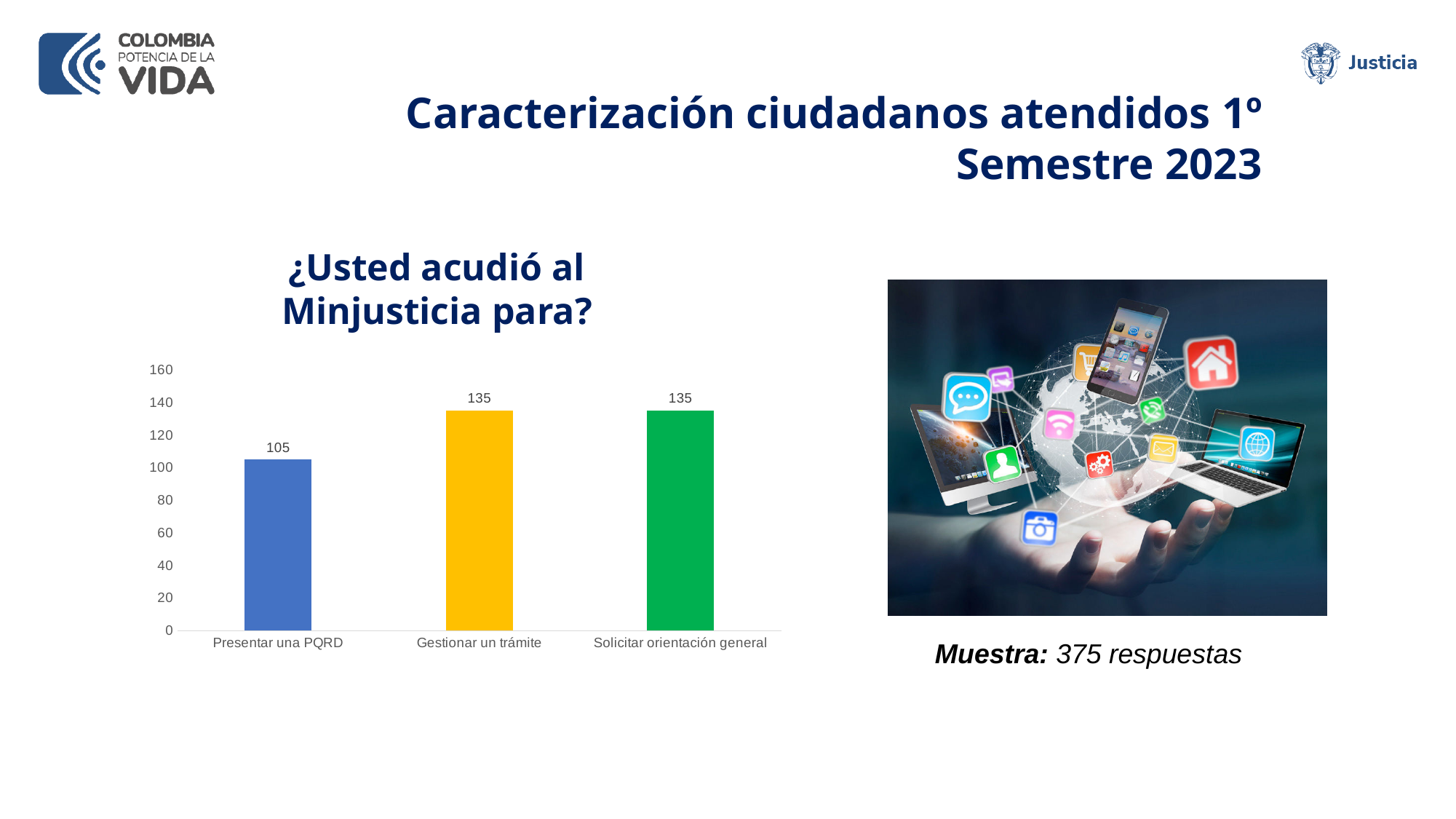
What is the title of the chart? ¿Usted acudió al Minjusticia para? How many categories are shown in the chart? 3 Is the value for "Presentar una PQRD" greater or less than 120? less What is the value for "Presentar una PQRD"? 105 Is the value for "Gestionar un trámite" greater or less than 120? greater Which is larger, the value for "Presentar una PQRD" or the value for "Solicitar orientación general"? Solicitar orientación general Which category has the lowest value? Presentar una PQRD What colour is the bar for "Gestionar un trámite"? Yellow What is the value for "Solicitar orientación general"? 135 What kind of chart is shown on the slide? Bar chart What is the value for "Gestionar un trámite"? 135 What is the difference between the values for "Gestionar un trámite" and "Presentar una PQRD"? 30